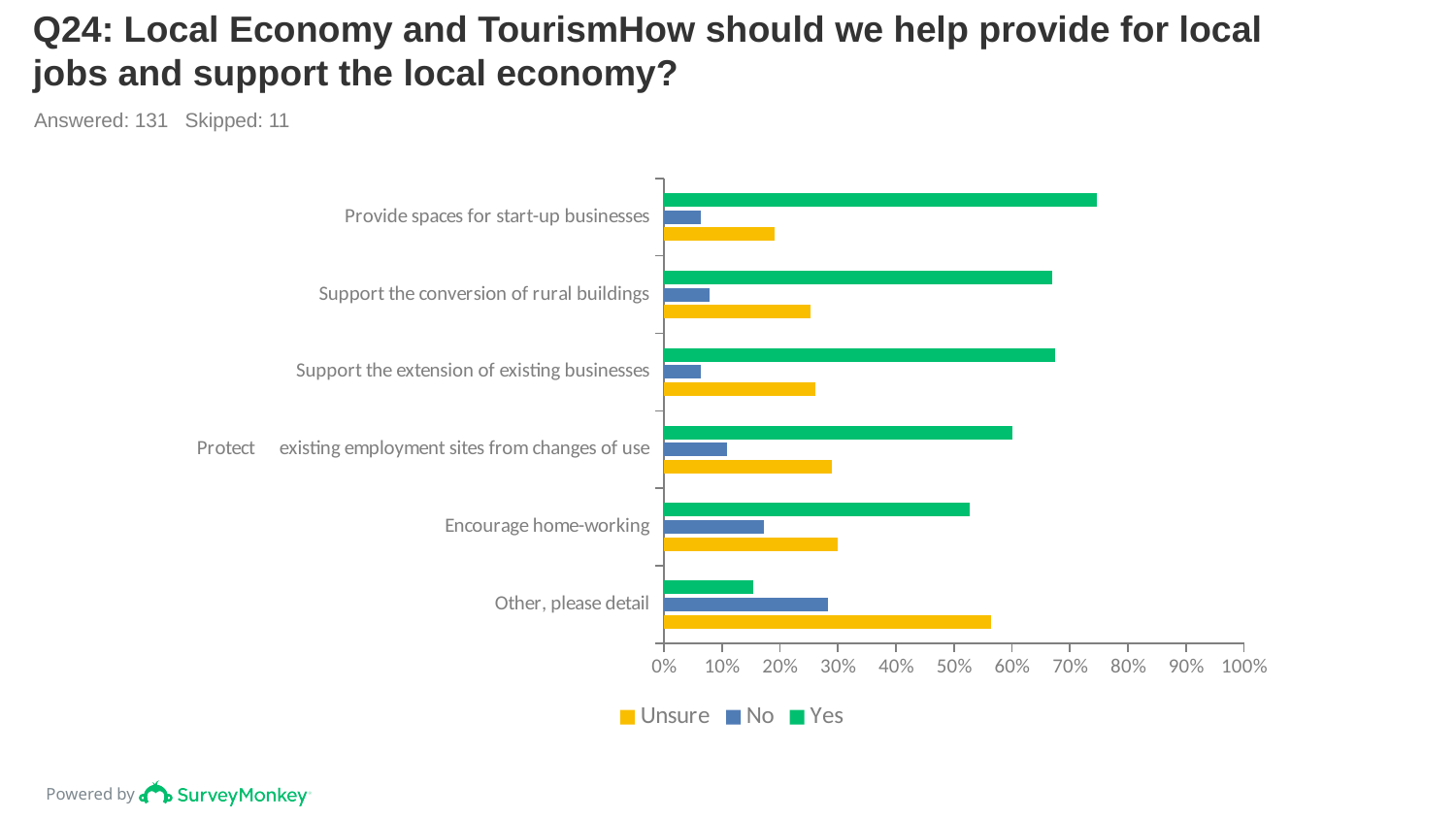
Which is larger: the 'Yes' value for 'Protect existing employment sites from changes of use' or the 'Yes' value for 'Encourage home-working'? Protect existing employment sites from changes of use Which category has the highest 'No' value? Other, please detail Is the 'No' value for 'Encourage home-working' greater or less than 20%? less Which category has the highest 'Unsure' value? Other, please detail How many series does the legend list? 3 Which category has the lowest 'Yes' value? Other, please detail Is the 'Yes' value for 'Provide spaces for start-up businesses' greater or less than 70%? greater How many answer categories are plotted on the chart? 6 Which category has the highest 'Yes' value? Provide spaces for start-up businesses What kind of chart is shown on the slide? bar chart Which series is shown in green in the legend? Yes Is the 'Yes' value for 'Encourage home-working' greater or less than 50%? greater